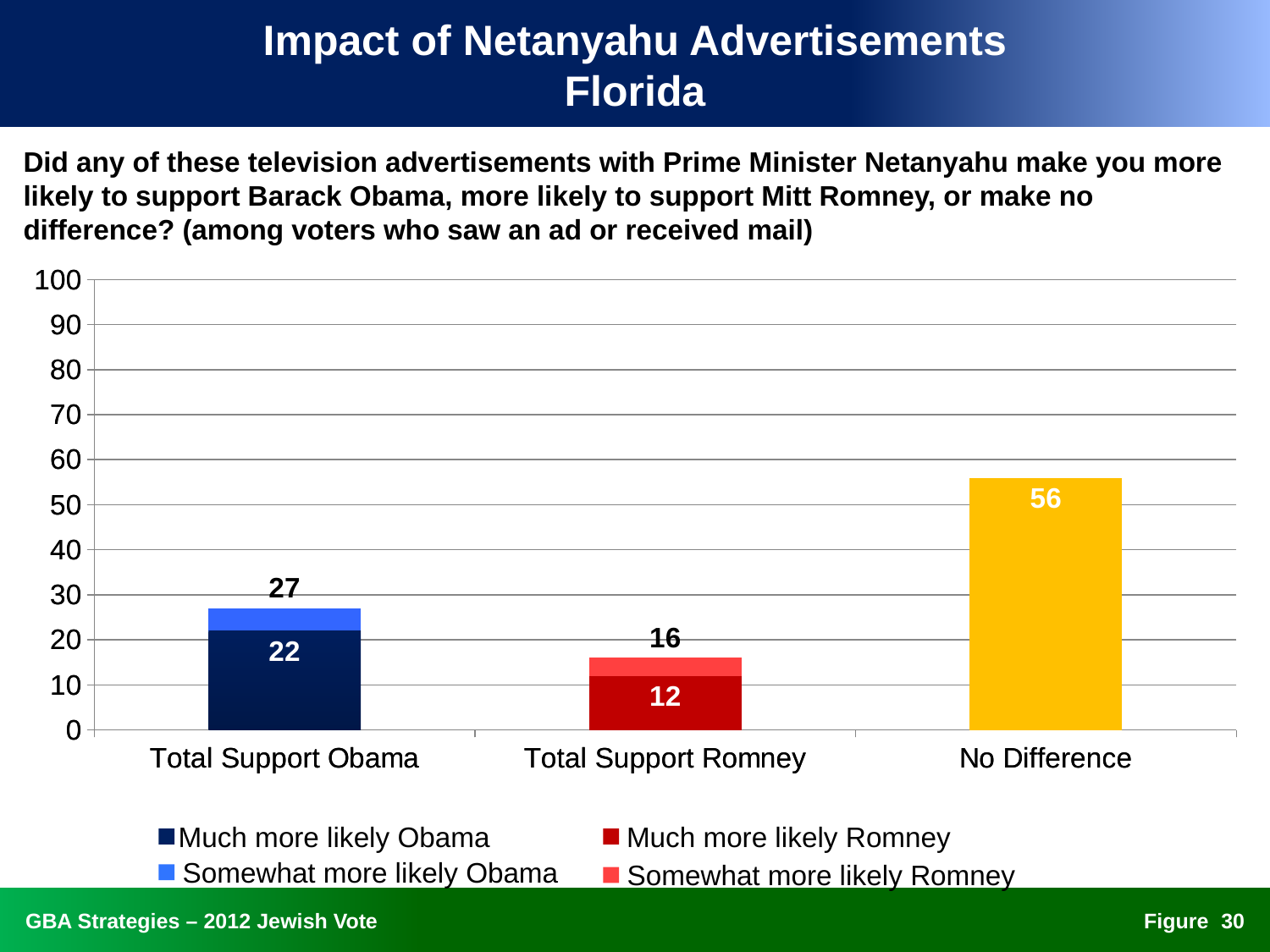
How many series does the legend list? 4 What kind of chart is shown on the slide? bar chart What is the value for No Difference? 56 Which is larger: the Total Support Obama total or the Total Support Romney total? Total Support Obama What is the value for "Much more likely Romney" in the Total Support Romney bar? 12 What is the difference between the No Difference value and the Total Support Obama total? 29 What is the value for "Much more likely Obama" in the Total Support Obama bar? 22 Which category has the highest value? No Difference What is the total of the Total Support Obama stacked bar? 27 How many categories are shown on the x axis? 3 What is the total of the Total Support Romney stacked bar? 16 Which category has the lowest total? Total Support Romney